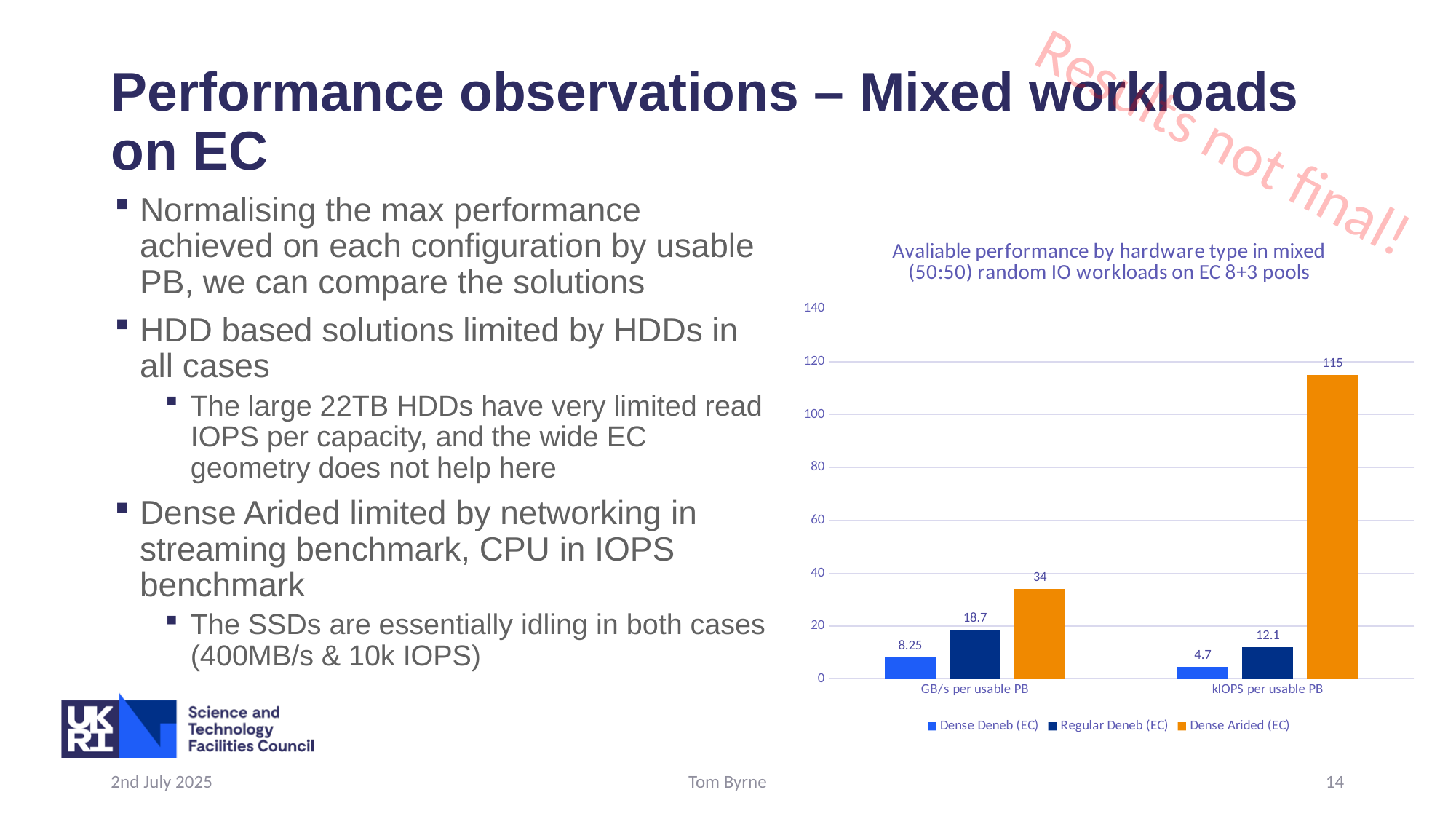
What is the title of the chart? Avaliable performance by hardware type in mixed (50:50) random IO workloads on EC 8+3 pools What is the value for Dense Arided (EC) in the GB/s per usable PB category? 34 What is the value for Dense Deneb (EC) in the GB/s per usable PB category? 8.25 What is the value for Regular Deneb (EC) in the kIOPS per usable PB category? 12.1 Which series has the lowest value in the GB/s per usable PB category? Dense Deneb (EC) How many series does the legend list? 3 What is the difference between the Dense Arided (EC) and Regular Deneb (EC) values in the kIOPS per usable PB category? 102.9 Which series has the highest value in the kIOPS per usable PB category? Dense Arided (EC) What kind of chart is shown on the slide? Bar chart Which is larger: Regular Deneb (EC) in GB/s per usable PB or Regular Deneb (EC) in kIOPS per usable PB? GB/s per usable PB What is the difference between the Regular Deneb (EC) and Dense Deneb (EC) values in the GB/s per usable PB category? 10.45 Is the value for Dense Arided (EC) in kIOPS per usable PB greater or less than 100? greater